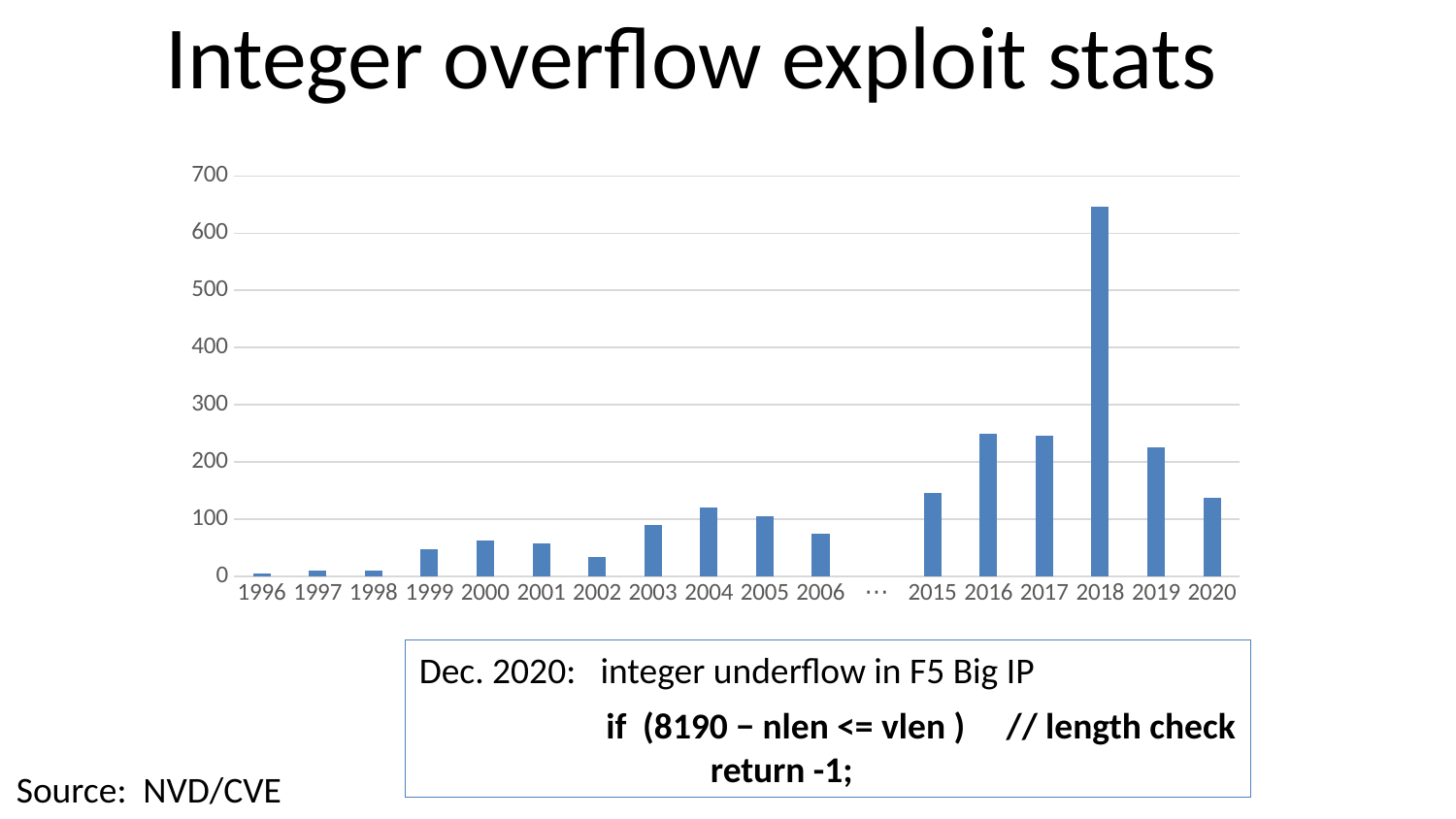
Is the value for 2002 greater or less than 50? less What is the title of the chart? Integer overflow exploit stats Which year has the highest bar in the chart? 2018 Which year has the larger value, 2004 or 2002? 2004 How many bars are plotted in the chart? 17 Is the value for 2006 greater or less than 100? less Which year has the larger value, 2019 or 2020? 2019 Is the value for 2016 greater or less than 200? greater Do the values generally rise or fall from 1996 to 2004? rise What kind of chart is shown on the slide? bar chart